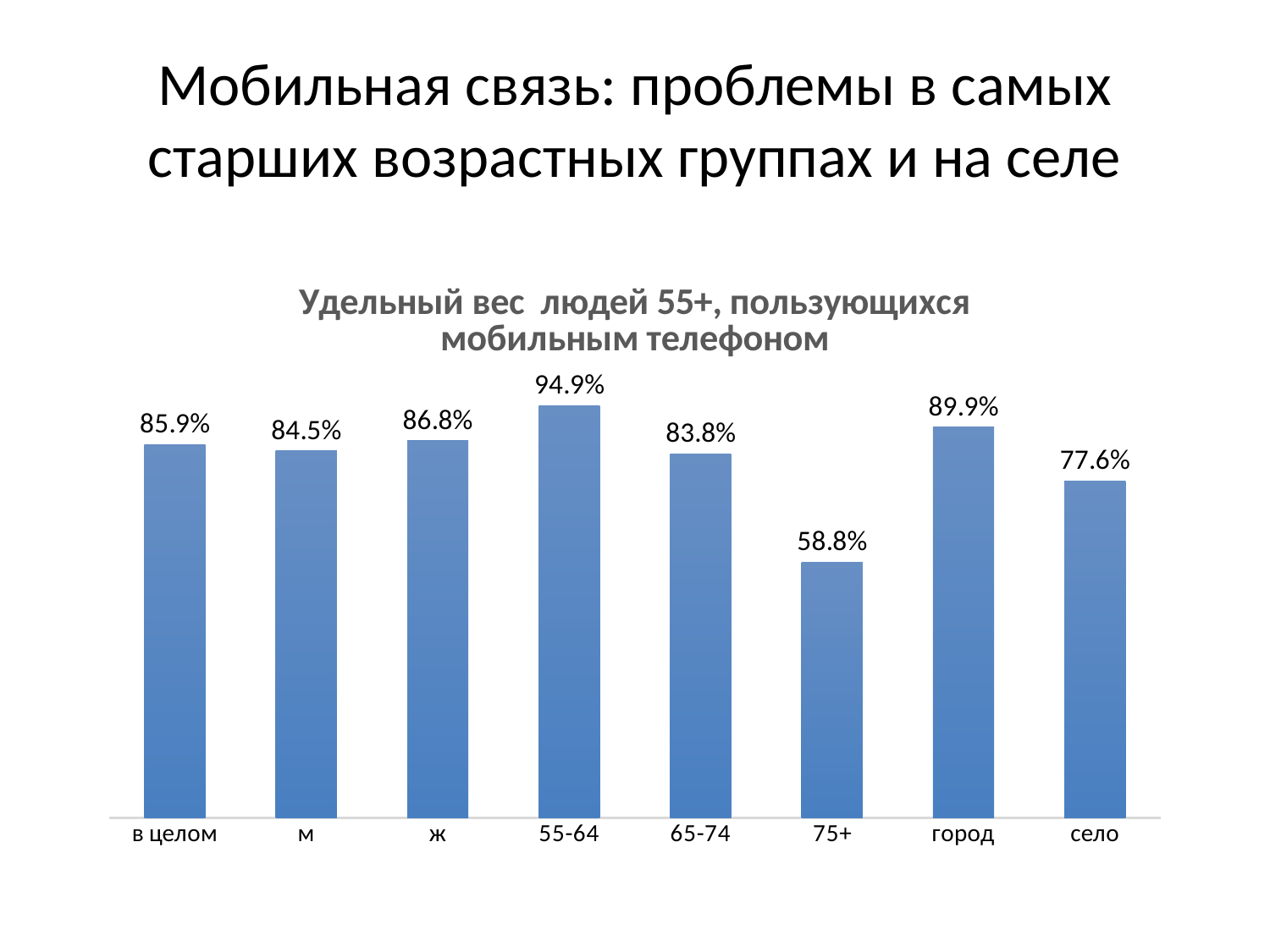
What is the value for the category "в целом"? 85.9% What is the value for the category "75+"? 58.8% How many categories are shown on the x axis? 8 What is the difference between the values for "город" and "село"? 12.3% What is the value for the category "село"? 77.6% Which category has the highest value? 55-64 Which is larger, the value for "ж" or the value for "м"? ж Which category has the lowest value? 75+ What is the value for the category "город"? 89.9% What is the title of the chart? Удельный вес людей 55+, пользующихся мобильным телефоном What is the difference between the values for "55-64" and "75+"? 36.1% What kind of chart is shown on the slide? bar chart